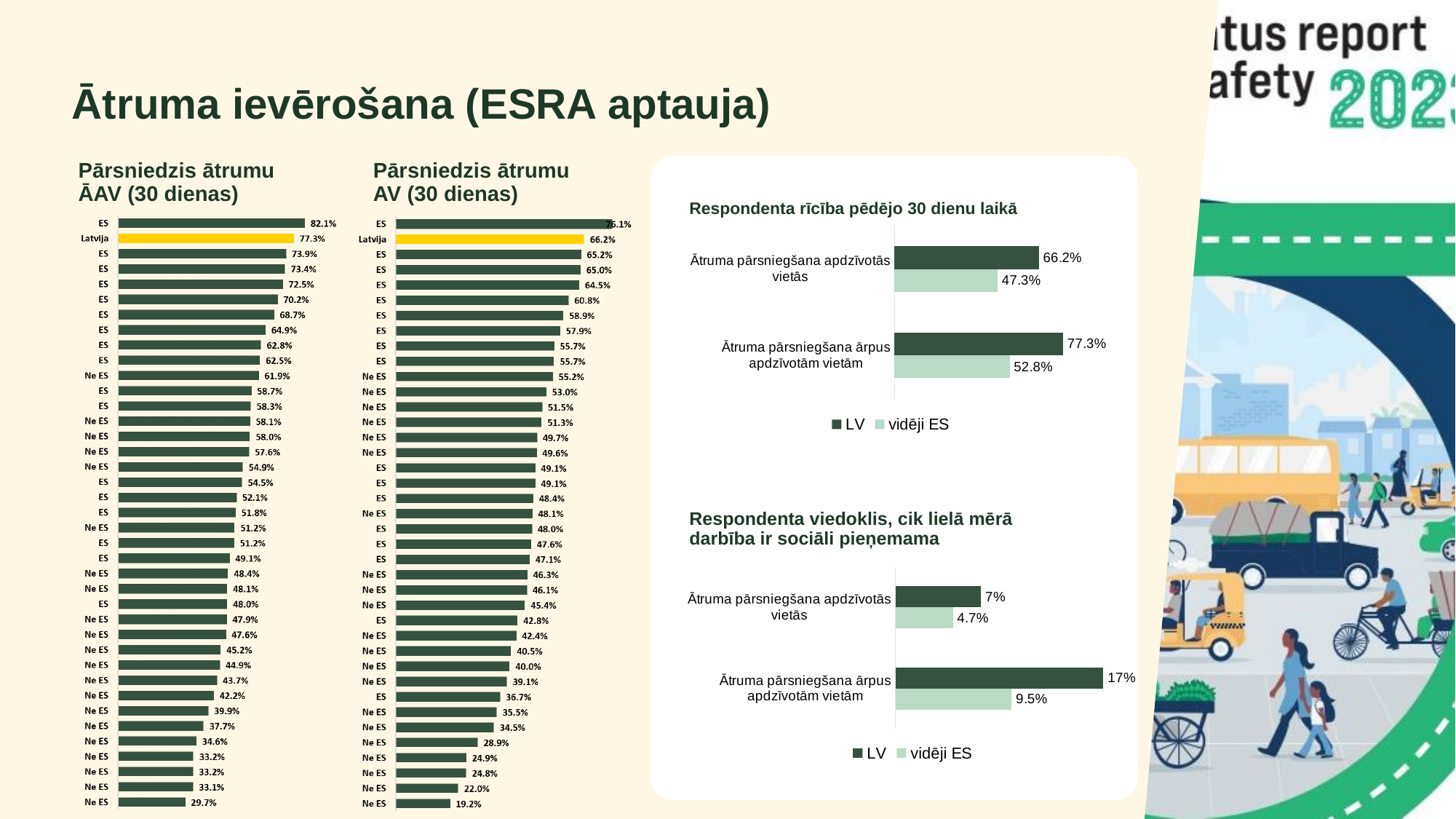
In the chart 'Pārsniedzis ātrumu ĀAV (30 dienas)', what is the value for Latvija? 77.3% In the chart 'Respondenta rīcība pēdējo 30 dienu laikā', what is the difference between the LV and 'vidēji ES' values for 'Ātruma pārsniegšana ārpus apdzīvotām vietām'? 24.5 percentage points In the chart 'Respondenta viedoklis, cik lielā mērā darbība ir sociāli pieņemama', what is the LV value for 'Ātruma pārsniegšana ārpus apdzīvotām vietām'? 17% In the chart 'Pārsniedzis ātrumu AV (30 dienas)', what is the value for Latvija? 66.2% In the chart 'Pārsniedzis ātrumu ĀAV (30 dienas)', what is the lowest value shown? 29.7% How many series does the legend of the chart 'Respondenta rīcība pēdējo 30 dienu laikā' list? 2 In the chart 'Respondenta viedoklis, cik lielā mērā darbība ir sociāli pieņemama', which is larger for 'Ātruma pārsniegšana ārpus apdzīvotām vietām': LV or vidēji ES? LV In the chart 'Respondenta viedoklis, cik lielā mērā darbība ir sociāli pieņemama', what is the 'vidēji ES' value for 'Ātruma pārsniegšana apdzīvotās vietās'? 4.7% In the chart 'Pārsniedzis ātrumu AV (30 dienas)', what is the lowest value shown? 19.2% In the chart 'Respondenta rīcība pēdējo 30 dienu laikā', what is the 'vidēji ES' value for 'Ātruma pārsniegšana apdzīvotās vietās'? 47.3% What kind of chart is 'Respondenta viedoklis, cik lielā mērā darbība ir sociāli pieņemama'? Bar chart In the chart 'Respondenta rīcība pēdējo 30 dienu laikā', what is the LV value for 'Ātruma pārsniegšana ārpus apdzīvotām vietām'? 77.3%